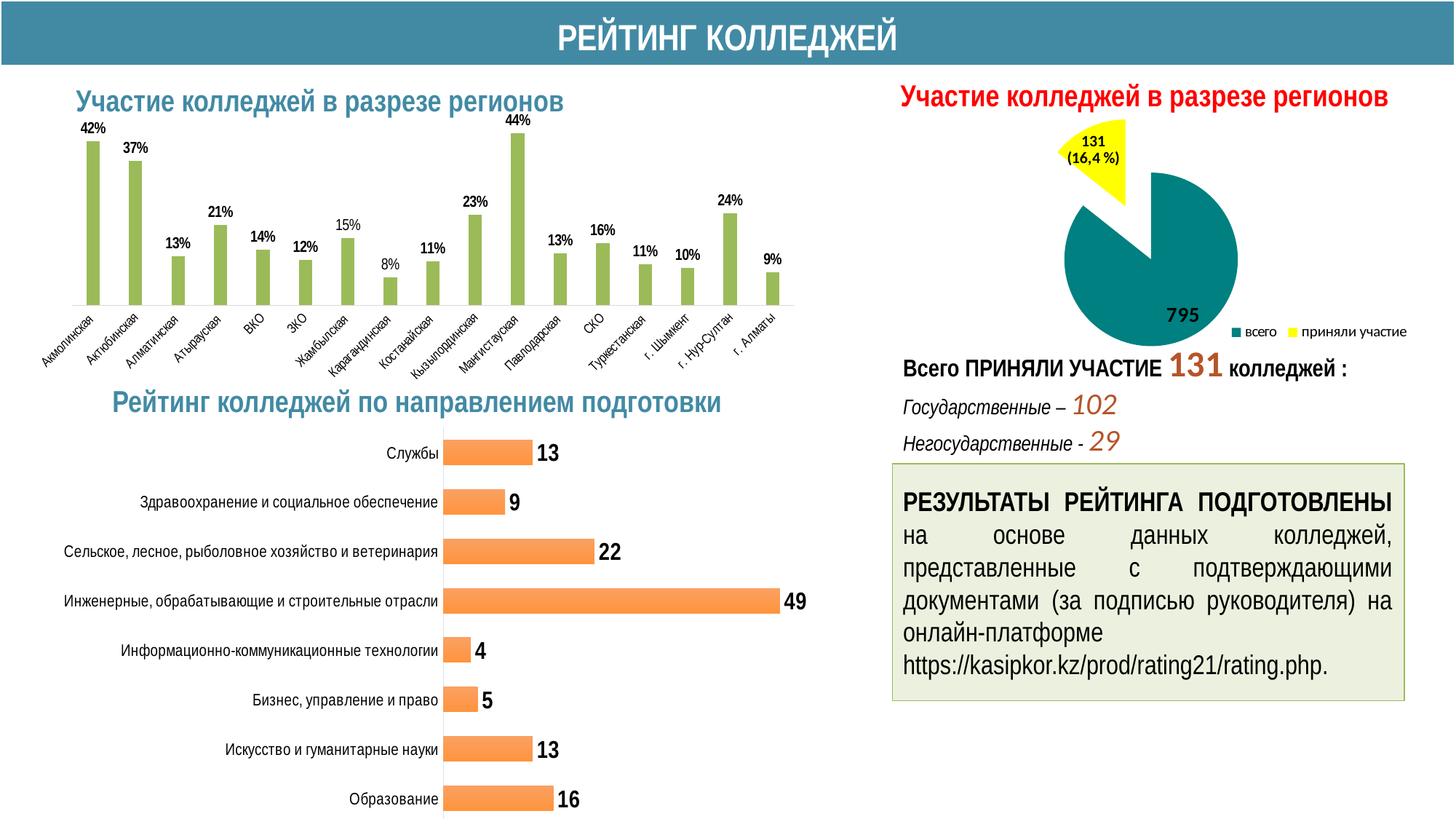
In the bottom-left chart 'Рейтинг колледжей по направлением подготовки', which category has the lowest value? Информационно-коммуникационные технологии In the pie chart on the right, what is the value for 'приняли участие'? 131 (16,4 %) In the bottom-left chart 'Рейтинг колледжей по направлением подготовки', which category has the highest value? Инженерные, обрабатывающие и строительные отрасли In the top-left bar chart 'Участие колледжей в разрезе регионов', which region has the highest value? Мангистауская What kind of chart is the bottom-left chart 'Рейтинг колледжей по направлением подготовки'? Bar chart In the top-left bar chart 'Участие колледжей в разрезе регионов', how many regions are shown? 17 In the top-left bar chart 'Участие колледжей в разрезе регионов', what is the difference between Акмолинская and Актюбинская? 5% In the top-left bar chart 'Участие колледжей в разрезе регионов', what is the value for Мангистауская? 44% In the top-left bar chart 'Участие колледжей в разрезе регионов', which region has the lowest value? Карагандинская In the bottom-left chart 'Рейтинг колледжей по направлением подготовки', what is the value for Образование? 16 In the bottom-left chart 'Рейтинг колледжей по направлением подготовки', which is larger: Сельское, лесное, рыболовное хозяйство и ветеринария or Здравоохранение и социальное обеспечение? Сельское, лесное, рыболовное хозяйство и ветеринария How many series does the legend of the pie chart on the right list? 2